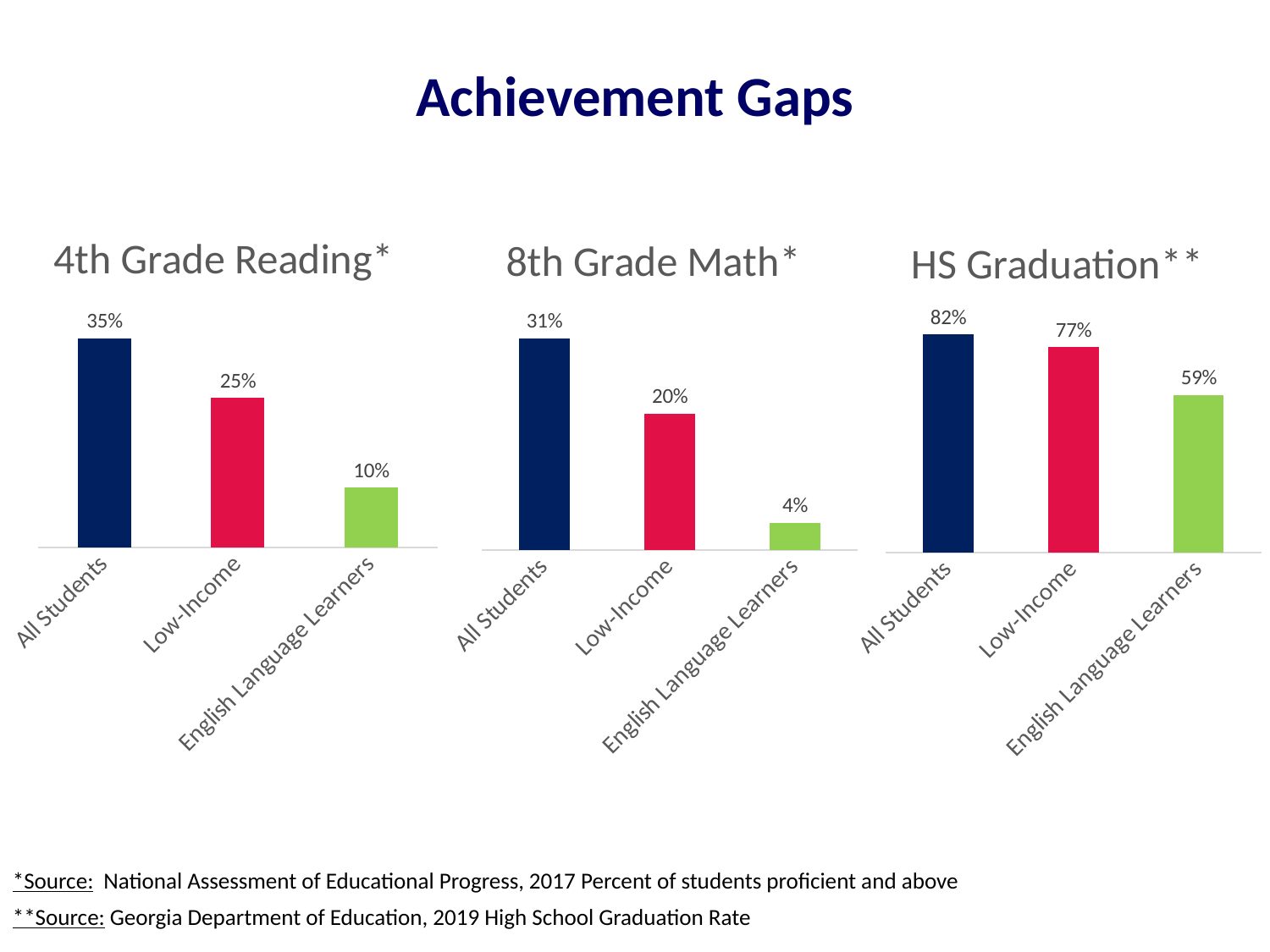
How many charts are shown on the slide? 3 How many categories are shown in the 8th Grade Math chart? 3 What kind of chart is the HS Graduation chart? Bar chart In the 8th Grade Math chart, which category has the highest value? All Students In the HS Graduation chart, which category has the lowest value? English Language Learners Which is larger: the Low-Income value in the 4th Grade Reading chart or the Low-Income value in the 8th Grade Math chart? 4th Grade Reading In the 4th Grade Reading chart, what is the value for Low-Income? 25% In the 8th Grade Math chart, what is the value for English Language Learners? 4% In the HS Graduation chart, what is the value for All Students? 82% In the HS Graduation chart, what is the difference between Low-Income and English Language Learners? 18% In the 4th Grade Reading chart, do the values rise or fall from left to right? Fall In the 4th Grade Reading chart, what is the difference between All Students and English Language Learners? 25%